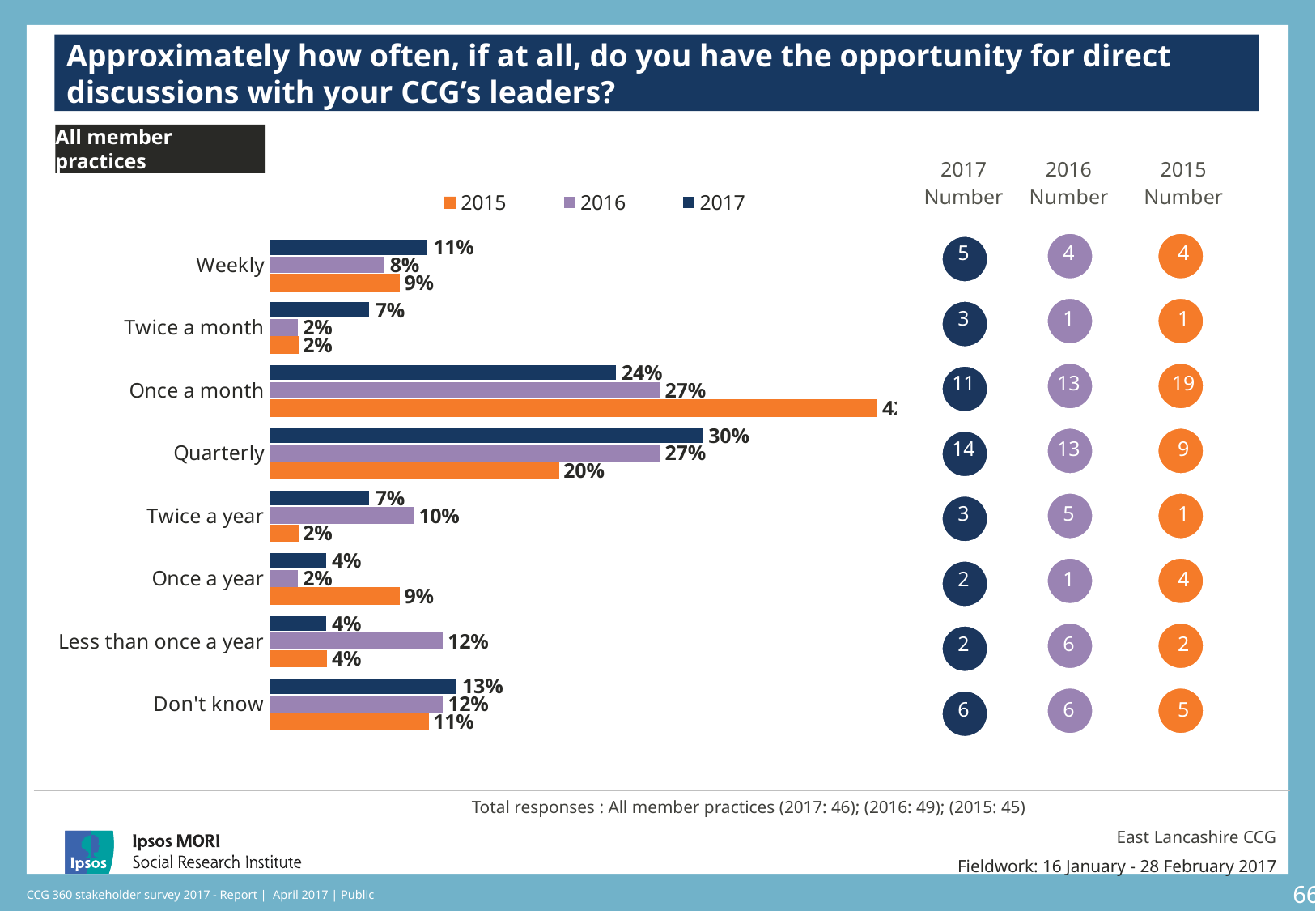
What is the 2017 value for Quarterly? 30% For Twice a year, which is larger: the 2016 value or the 2017 value? 2016 Which category has the highest 2017 value? Quarterly What is the difference between the 2017 and 2015 values for Quarterly? 10 percentage points What is the 2015 value for Once a year? 9% What is the 2017 value for Don't know? 13% Which category has the highest 2015 value? Once a month Which colour represents the 2015 series in the legend? Orange What type of chart is shown on the slide? Bar chart How many series does the chart legend list? 3 How many response categories are plotted on the chart? 8 What is the 2016 value for Less than once a year? 12%